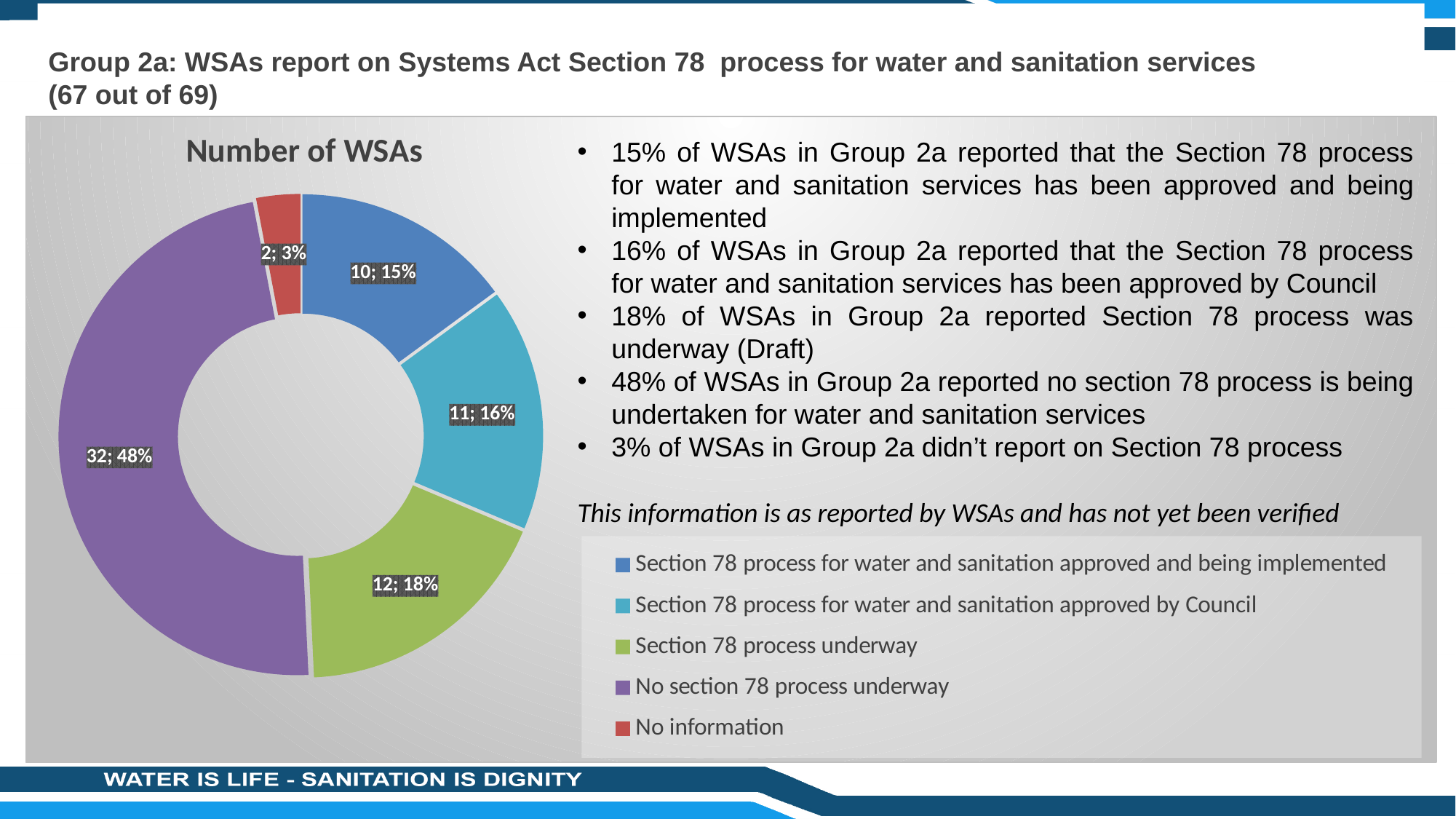
What is the difference in the number of WSAs between 'No section 78 process underway' and 'Section 78 process underway'? 20 Which category has the largest slice in the chart? No section 78 process underway Which has more WSAs: 'Section 78 process for water and sanitation approved by Council' or 'Section 78 process for water and sanitation approved and being implemented'? Section 78 process for water and sanitation approved by Council What colour is the slice for 'Section 78 process underway'? Green Which category has the smallest slice in the chart? No information What share of WSAs reported that the Section 78 process for water and sanitation was approved by Council? 16% How many WSAs reported that the Section 78 process was underway? 12 What share of the chart is the 'No information' slice? 3% How many WSAs reported no section 78 process underway? 32 What is the title of the chart? Number of WSAs What type of chart is shown on the slide? Doughnut chart How many categories does the legend list? 5